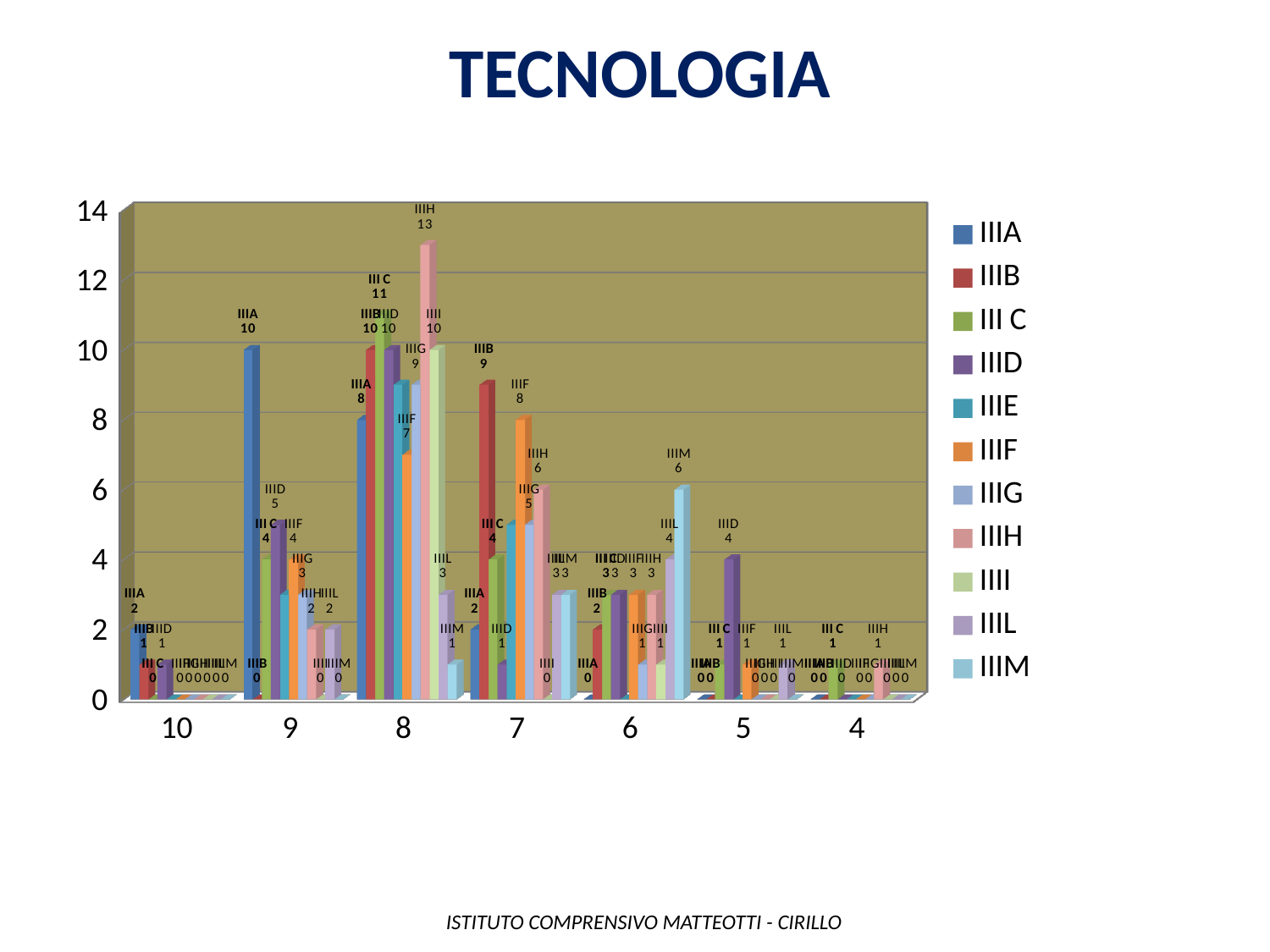
What is the value for IIIM in category 6? 6 How many categories are shown on the x axis? 7 What kind of chart is shown on the slide? bar chart What is the title of the chart? TECNOLOGIA What is the value for IIIH in category 8? 13 Which is larger in category 7: IIIB or IIIF? IIIB What is the value for III C in category 8? 11 What is the difference between IIIH and III C in category 8? 2 What is the value for IIIA in category 9? 10 How many series does the legend list? 11 Which series has the highest bar in category 8? IIIH What is the value for IIID in category 5? 4